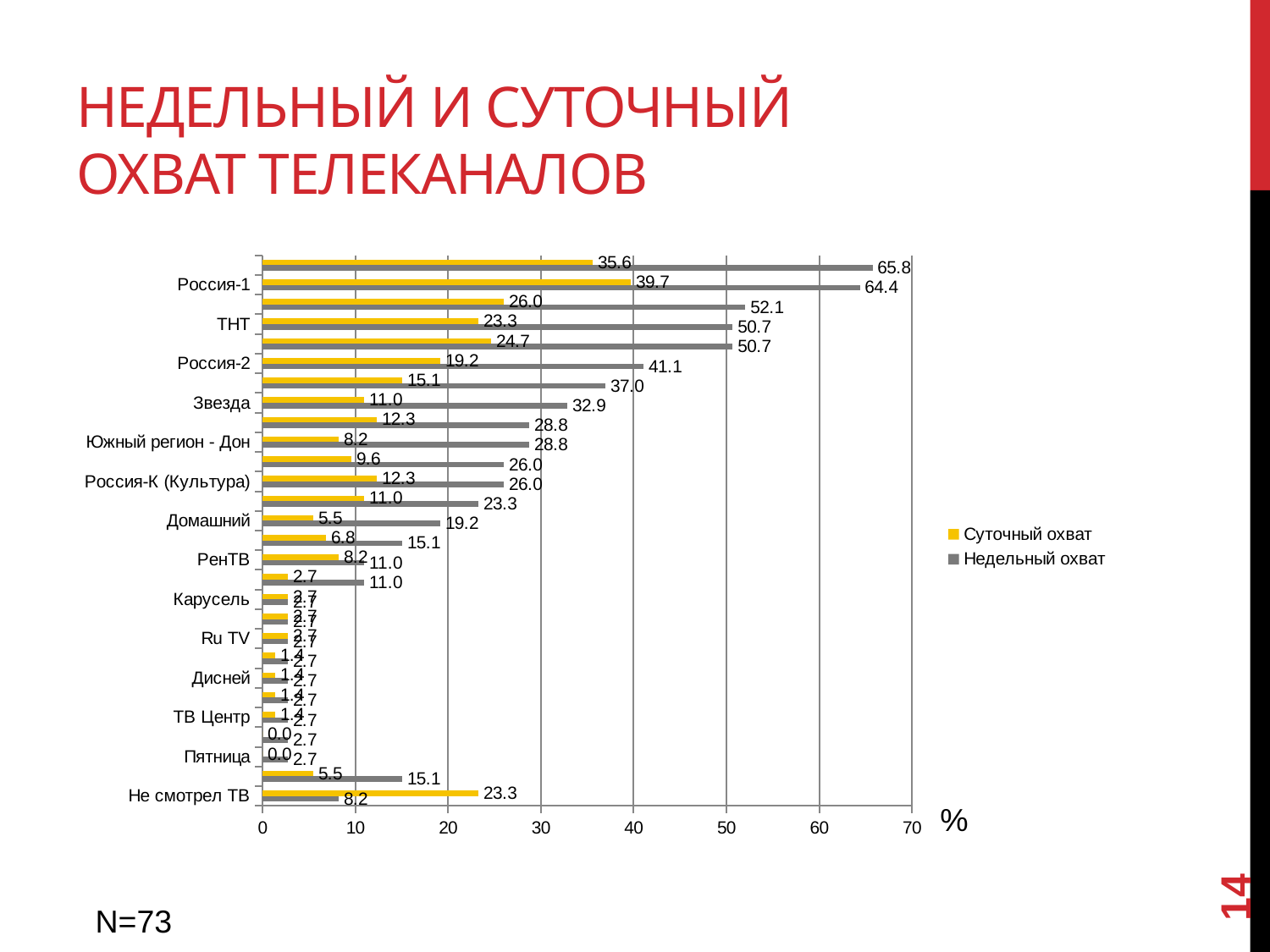
What unit is shown at the end of the horizontal axis? % How many series does the legend list? 2 What is the Недельный охват value for Россия-1? 64.4 What kind of chart is shown on the slide? Bar chart For Не смотрел ТВ, which is larger: Суточный охват or Недельный охват? Суточный охват Is the Недельный охват value for Звезда greater or less than 30? greater What is the Суточный охват value for Пятница? 0.0 What are the two series named in the legend? Суточный охват and Недельный охват What is the Суточный охват value for Россия-1? 39.7 What is the difference between the Недельный охват and Суточный охват values for Россия-1? 24.7 What is the Недельный охват value for Россия-2? 41.1 What is the Суточный охват value for Не смотрел ТВ? 23.3